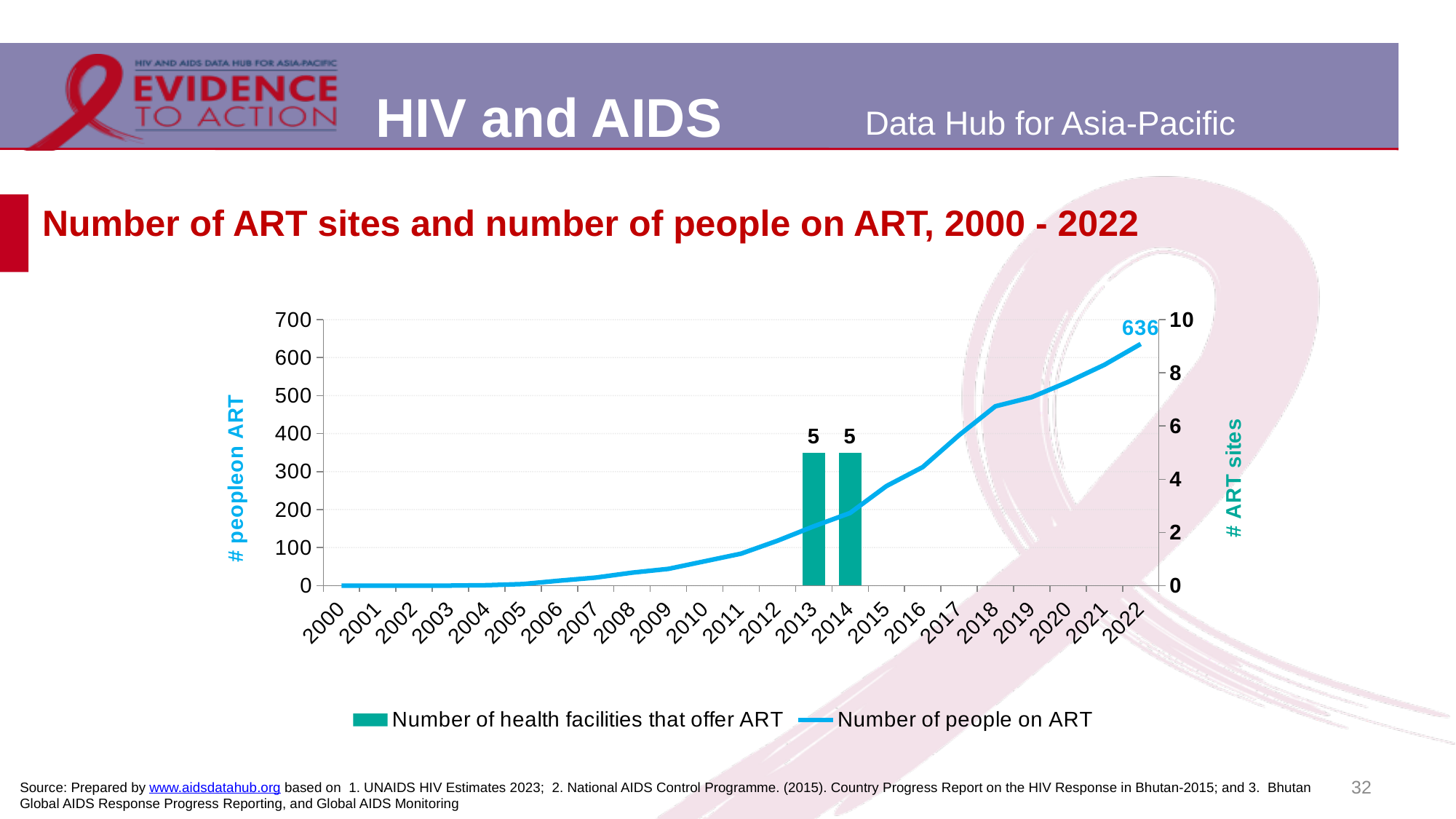
Is the number of people on ART in 2015 greater or less than 300? less What kind of chart is shown on the slide? A combined bar and line chart How many health facilities offered ART in 2013? 5 Is the number of people on ART in 2010 greater or less than 100? less Does the number of people on ART rise or fall from 2000 to 2022? Rise What is the title of the right-hand vertical axis? # ART sites What is the number of people on ART in 2022? 636 How many series does the legend list? 2 Is the number of people on ART in 2018 greater or less than 400? greater How many years are shown on the x axis? 23 In which year is the number of people on ART highest? 2022 How many health facilities offered ART in 2014? 5